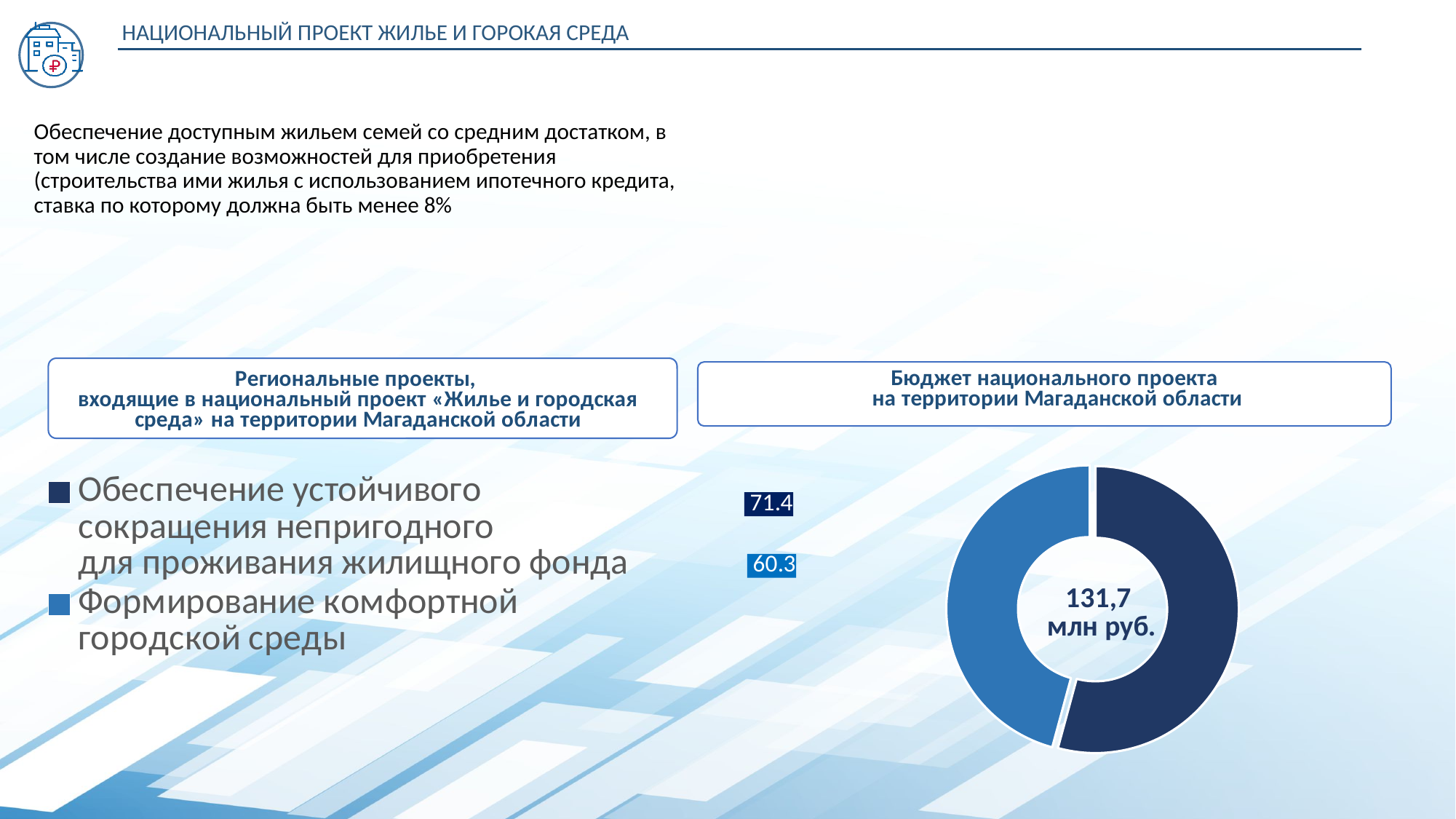
What type of chart is shown on the slide? Doughnut (pie) chart Which regional project has the smaller share of the budget? Формирование комфортной городской среды What is the difference between the values 71.4 and 60.3 shown on the chart? 11.1 What share of the total budget (131.7) does the 71.4 slice represent, to one decimal place? 54.2% What is the value for «Формирование комфортной городской среды»? 60.3 What is the value for «Обеспечение устойчивого сокращения непригодного для проживания жилищного фонда»? 71.4 How many slices does the doughnut chart have? 2 What colour is the slice for «Формирование комфортной городской среды»? Light blue What total budget is shown in the centre of the doughnut chart? 131,7 млн руб. Is the value for «Формирование комфортной городской среды» larger or smaller than the value for «Обеспечение устойчивого сокращения непригодного для проживания жилищного фонда»? Smaller Which regional project has the larger share of the budget? Обеспечение устойчивого сокращения непригодного для проживания жилищного фонда How many entries does the chart legend list? 2